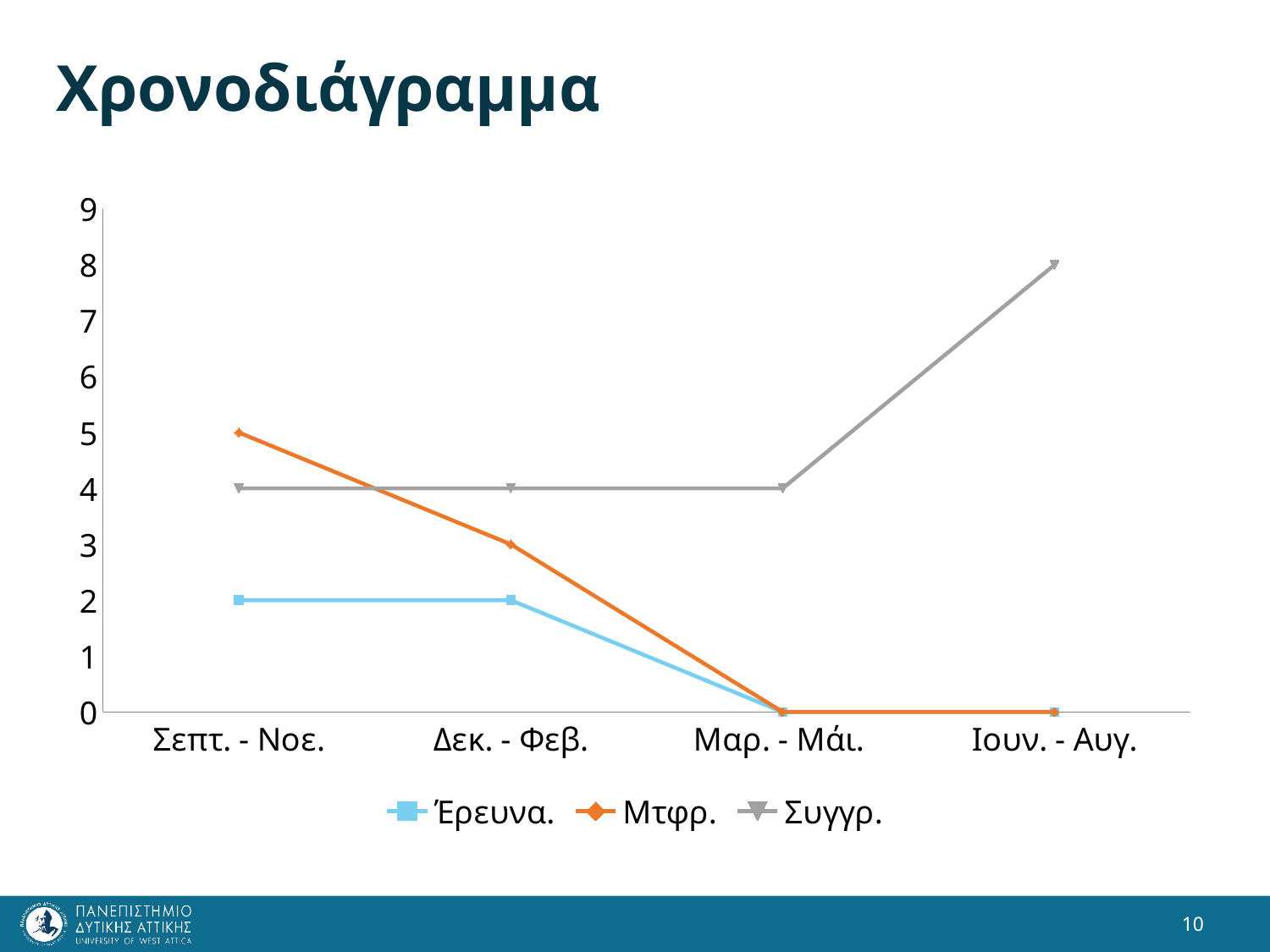
What is the title of the slide containing the chart? Χρονοδιάγραμμα How many series does the legend list? 3 In which period does Συγγρ. reach its highest value? Ιουν. - Αυγ. What is the value of Συγγρ. for Ιουν. - Αυγ.? 8 How many categories are shown on the x axis? 4 What kind of chart is shown on the slide? line chart Which series has the highest value for Σεπτ. - Νοε.? Μτφρ. Does the Μτφρ. series rise or fall from Σεπτ. - Νοε. to Μαρ. - Μάι.? fall What is the value of Έρευνα. for Δεκ. - Φεβ.? 2